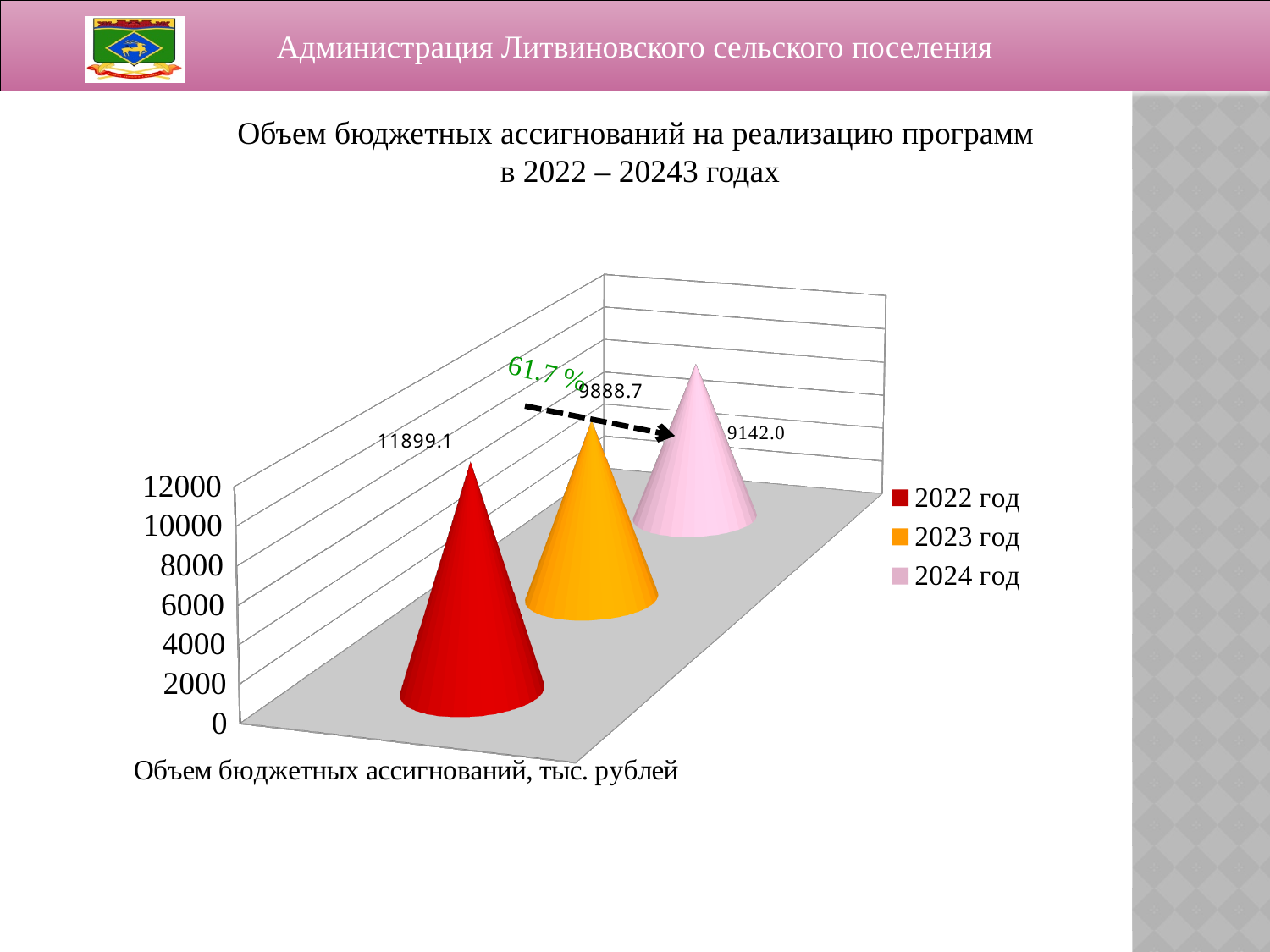
What is the value for 2022 год? 11899.1 What is the difference between the values for 2023 год and 2024 год? 746.7 Which year has the lowest value? 2024 год Which is larger, the value for 2022 год or the value for 2024 год? 2022 год What is the value for 2024 год? 9142.0 Do the values rise or fall from 2022 год to 2024 год? fall What is the difference between the values for 2022 год and 2023 год? 2010.4 What unit is given in the axis label below the chart? тыс. рублей Which year has the highest value? 2022 год Is the value for 2023 год greater or less than 10000? less How many series does the legend list? 3 What is the value for 2023 год? 9888.7